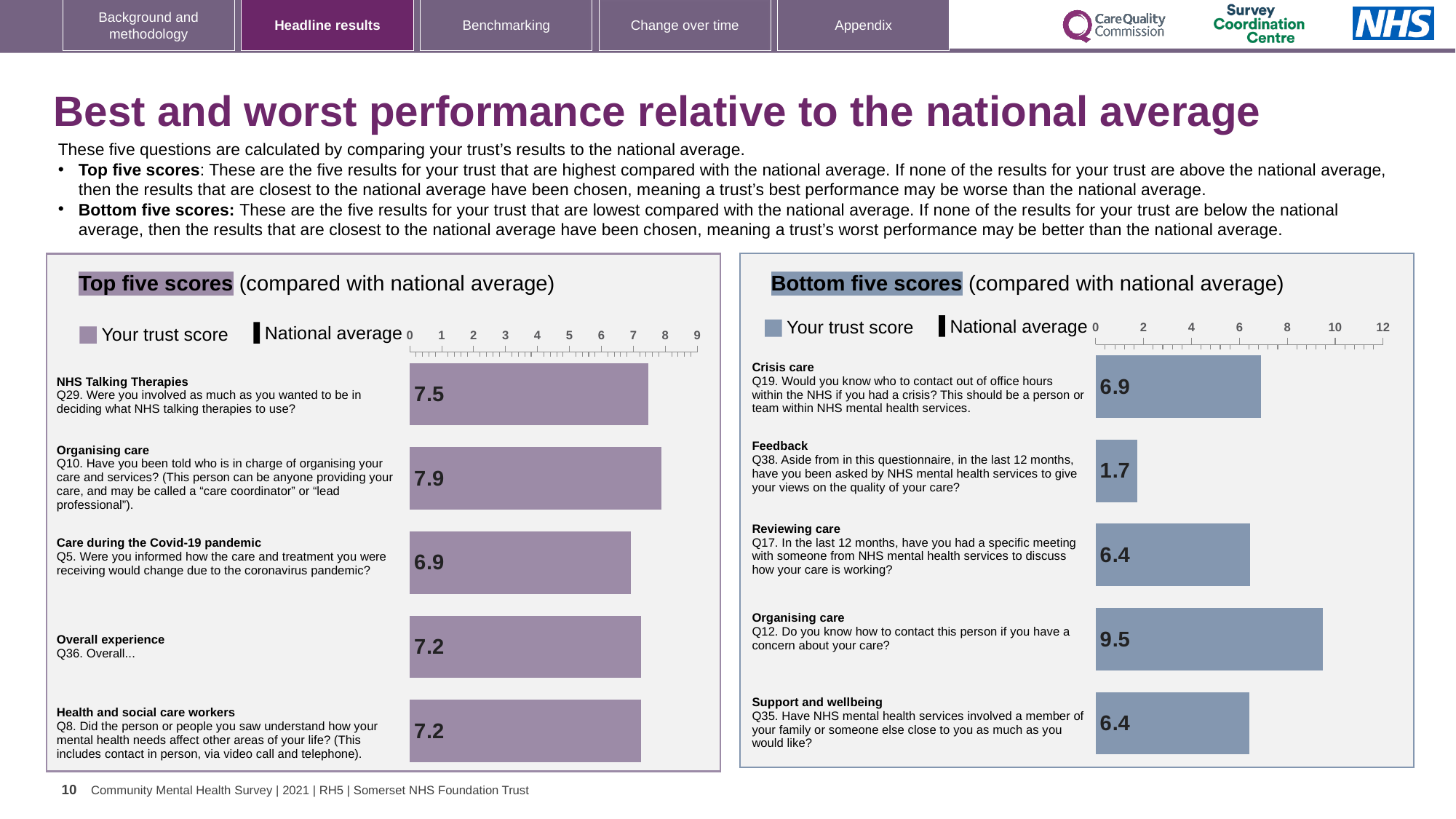
In the Top five scores chart, what is the trust score for Organising care (Q10)? 7.9 What kind of chart is the Top five scores chart? Bar chart In the Bottom five scores chart, which question has the highest trust score? Organising care (Q12) In the Bottom five scores chart, what is the trust score for Organising care (Q12)? 9.5 In the Bottom five scores chart, what is the difference between the trust scores for Crisis care (Q19) and Reviewing care (Q17)? 0.5 In the Top five scores chart, what is the trust score for Care during the Covid-19 pandemic (Q5)? 6.9 In the Top five scores chart, what is the difference between the trust scores for NHS Talking Therapies (Q29) and Overall experience (Q36)? 0.3 In the Bottom five scores chart, which question has the lowest trust score? Feedback (Q38) In the Top five scores chart, which question has the lowest trust score? Care during the Covid-19 pandemic (Q5) In the Bottom five scores chart, how many questions are plotted? 5 In the Top five scores chart, which question has the highest trust score? Organising care (Q10) In the Bottom five scores chart, what is the trust score for Feedback (Q38)? 1.7